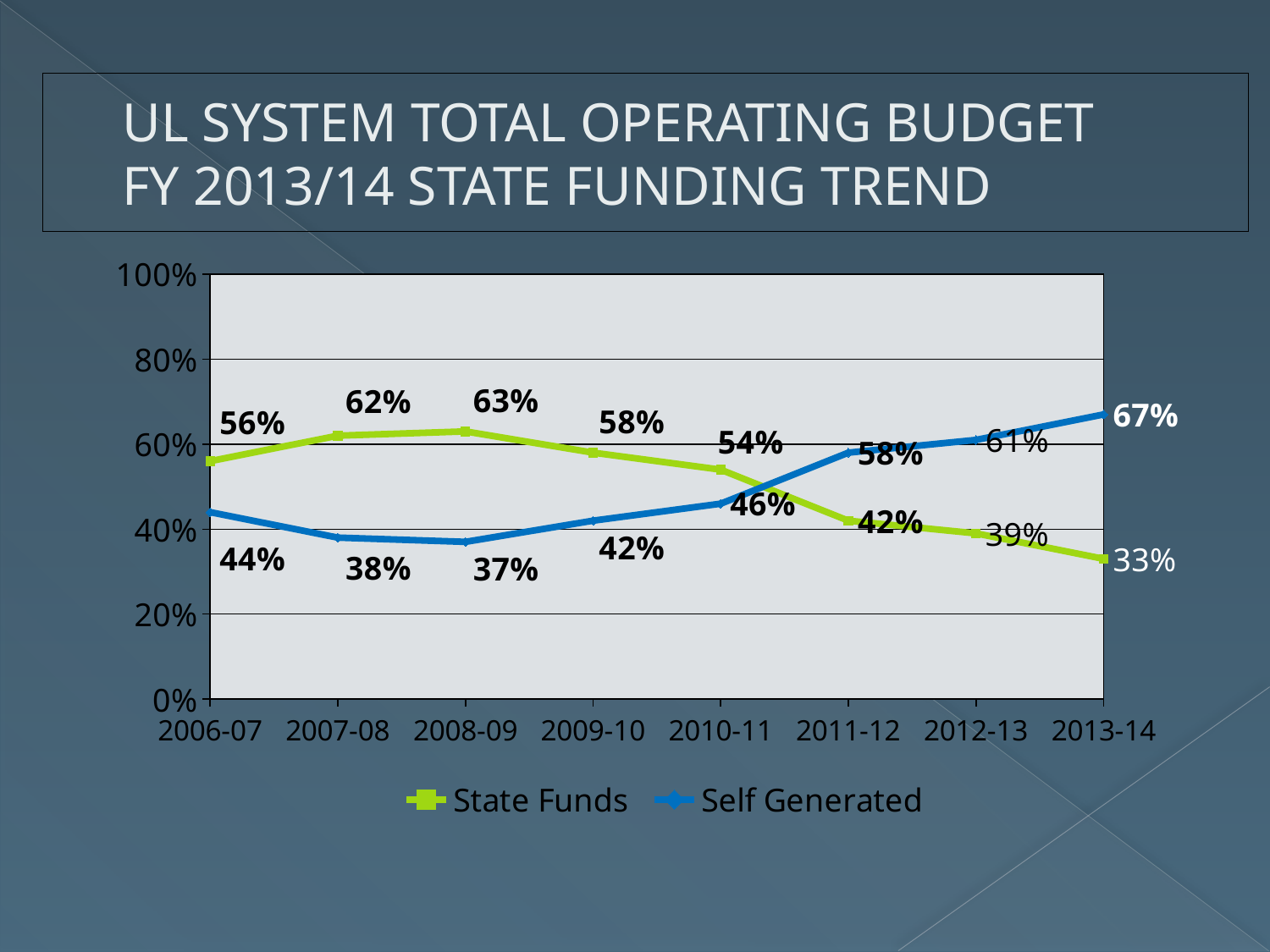
What kind of chart is shown on the slide? line chart What is the State Funds value for 2008-09? 63% Does the Self Generated series rise or fall from 2008-09 to 2013-14? rise What is the State Funds value for 2010-11? 54% What is the Self Generated value for 2013-14? 67% How many fiscal years are shown on the x axis? 8 What is the difference between the State Funds and Self Generated values in 2013-14? 34% Which is larger in 2009-10, State Funds or Self Generated? State Funds Which series is drawn in green? State Funds In which year is the State Funds value highest? 2008-09 In which year is the Self Generated value lowest? 2008-09 How many series does the legend list? 2